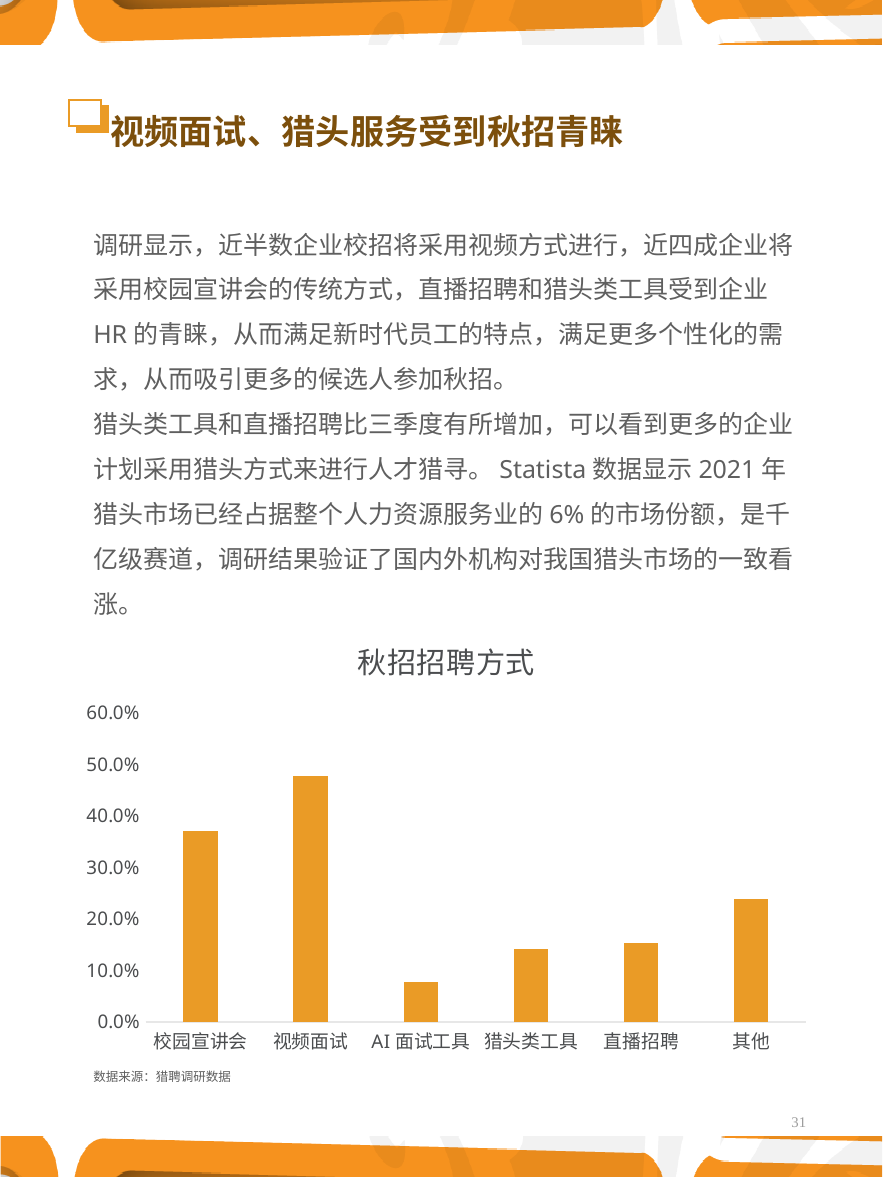
Which is larger in the 秋招招聘方式 chart, the value for 校园宣讲会 or the value for 其他? 校园宣讲会 How many recruitment methods (categories) are shown on the x axis of the 秋招招聘方式 chart? 6 Is the value for 视频面试 greater or less than 40.0%? greater Which is larger in the 秋招招聘方式 chart, the value for 视频面试 or the value for 校园宣讲会? 视频面试 Is the value for 其他 greater or less than 20.0%? greater Which recruitment method has the lowest value in the 秋招招聘方式 chart? AI 面试工具 What kind of chart is shown under the title 秋招招聘方式? bar chart Which recruitment method has the highest value in the 秋招招聘方式 chart? 视频面试 Is the value for AI 面试工具 greater or less than 10.0%? less What is the title of the chart on the slide? 秋招招聘方式